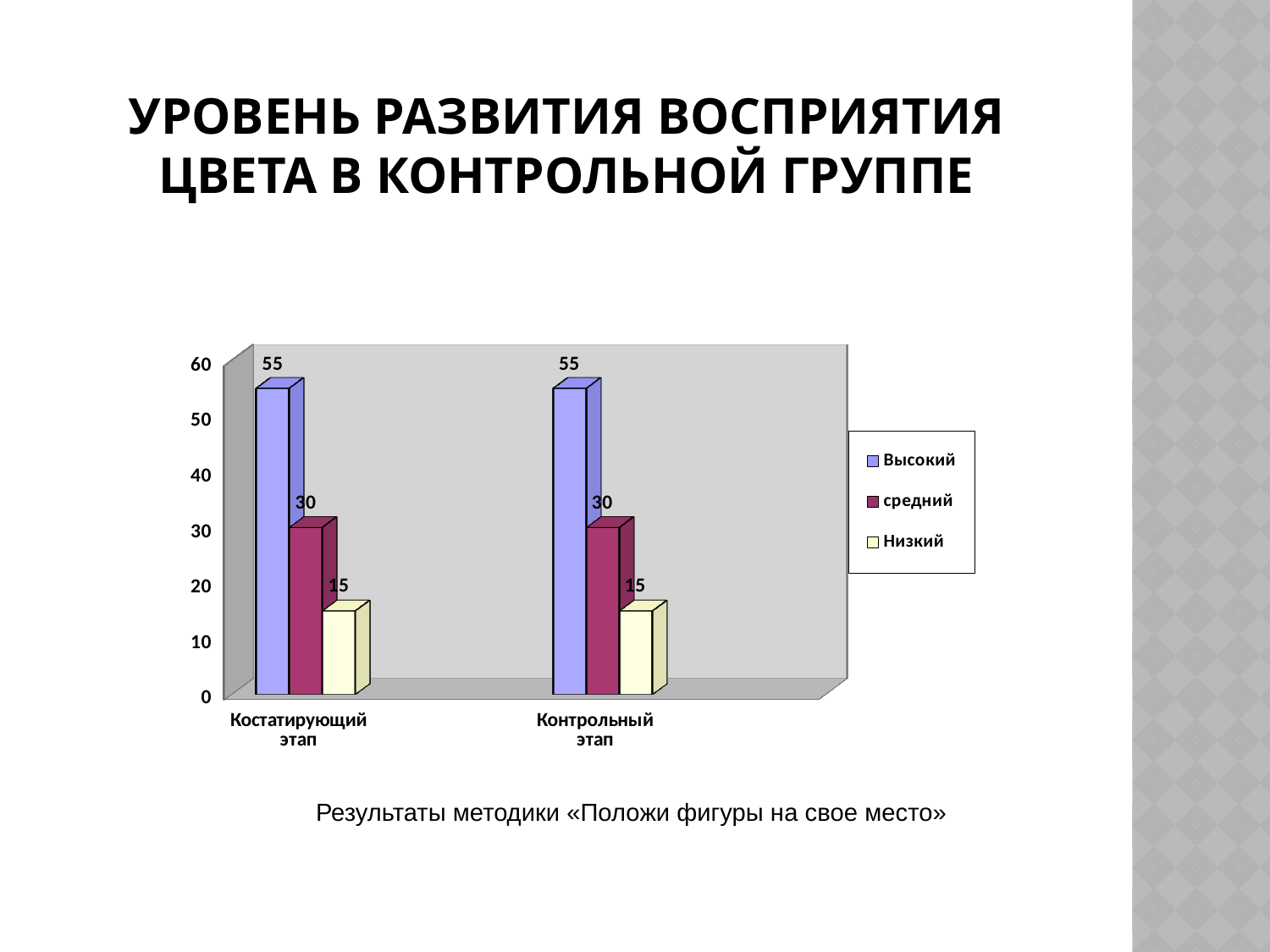
How many series does the legend list? 3 What kind of chart is shown on the slide? Bar chart How many categories are shown on the x axis? 2 What is the value for средний at Контрольный этап? 30 Which series has the highest value at Контрольный этап? Высокий What is the value for Низкий at Костатирующий этап? 15 What is the value for Высокий at Костатирующий этап? 55 Which is larger at Контрольный этап: Высокий or Низкий? Высокий Which series has the lowest value at Костатирующий этап? Низкий Does the Высокий value change from Костатирующий этап to Контрольный этап? No, it stays at 55 What is the difference between the Высокий and средний values at Костатирующий этап? 25 What is the difference between the средний and Низкий values at Контрольный этап? 15